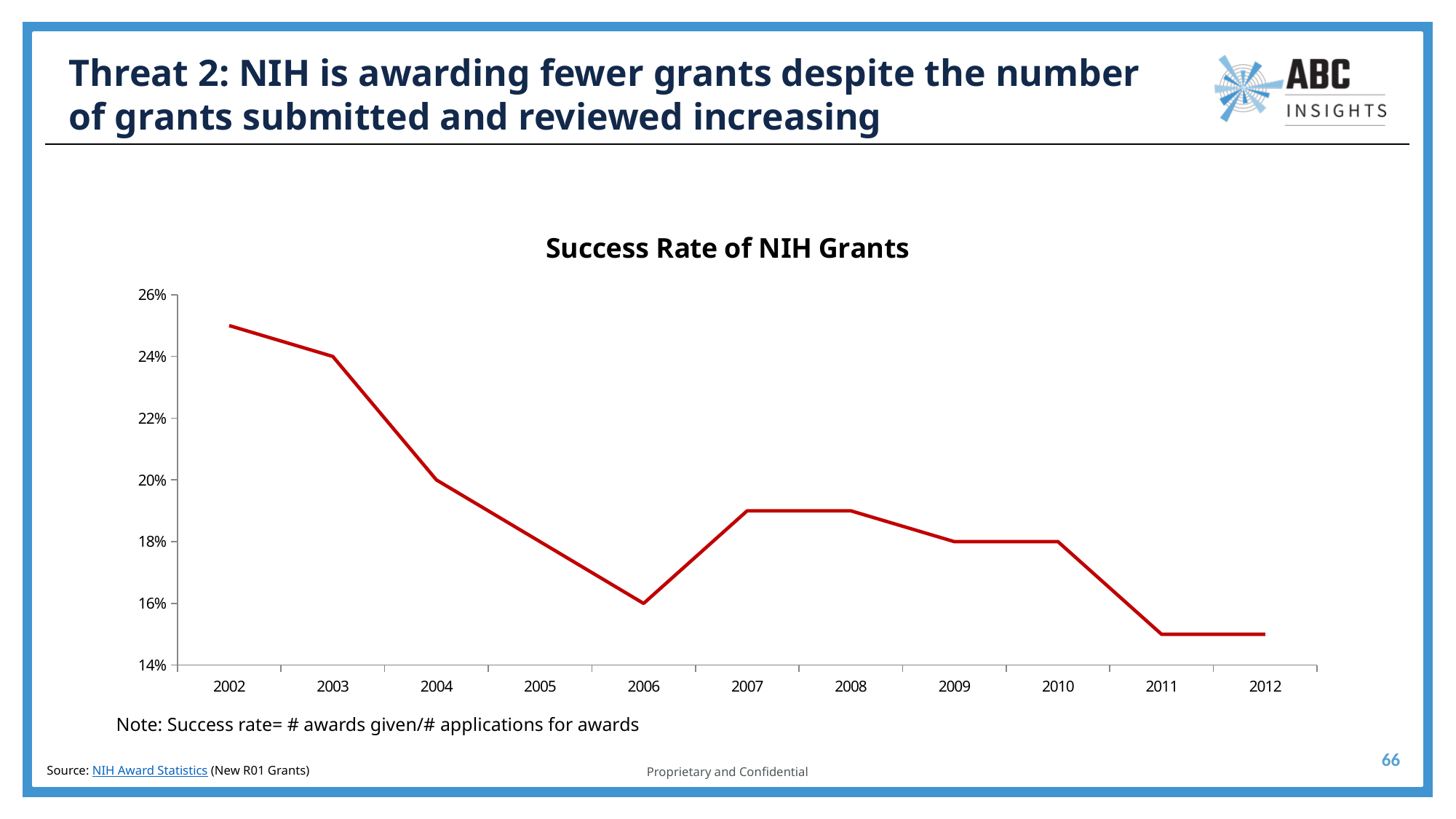
What was the success rate of NIH grants in 2003? 24% What is the title of the chart? Success Rate of NIH Grants How many years are plotted on the x axis? 11 Is the success rate for 2011 greater or less than 16%? less What was the success rate of NIH grants in 2004? 20% Which year has the highest success rate on the chart? 2002 By how many percentage points did the success rate fall from 2003 to 2006? 8 percentage points What was the success rate of NIH grants in 2006? 16% Which year had a higher success rate, 2004 or 2009? 2004 What type of chart is shown on the slide? line chart What was the success rate of NIH grants in 2010? 18% Does the success rate generally rise or fall from 2002 to 2012? fall